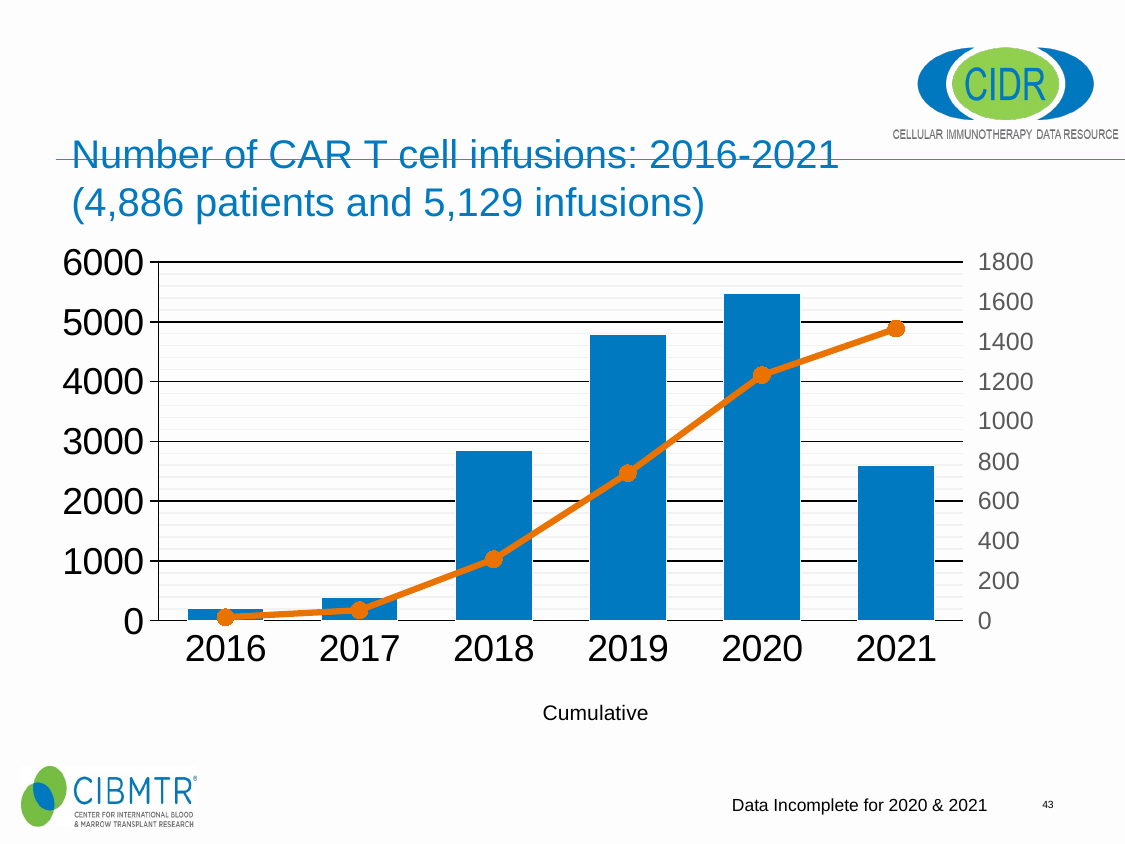
Which year has the taller bar, 2019 or 2021? 2019 Which year has the shortest bar in the chart? 2016 How many years are shown on the x axis of the chart? 6 What is the title of the chart on the slide? Number of CAR T cell infusions: 2016-2021 (4,886 patients and 5,129 infusions) Does the Cumulative line rise or fall from 2016 to 2021? rises Which year has the taller bar, 2017 or 2018? 2018 Is the bar value for 2016 greater or less than 1000? less Which year has the tallest bar in the chart? 2020 What kind of chart is shown on the slide? bar chart with a line Is the bar value for 2020 greater or less than 1000? greater Is the Cumulative value for 2021 greater or less than 1000? greater